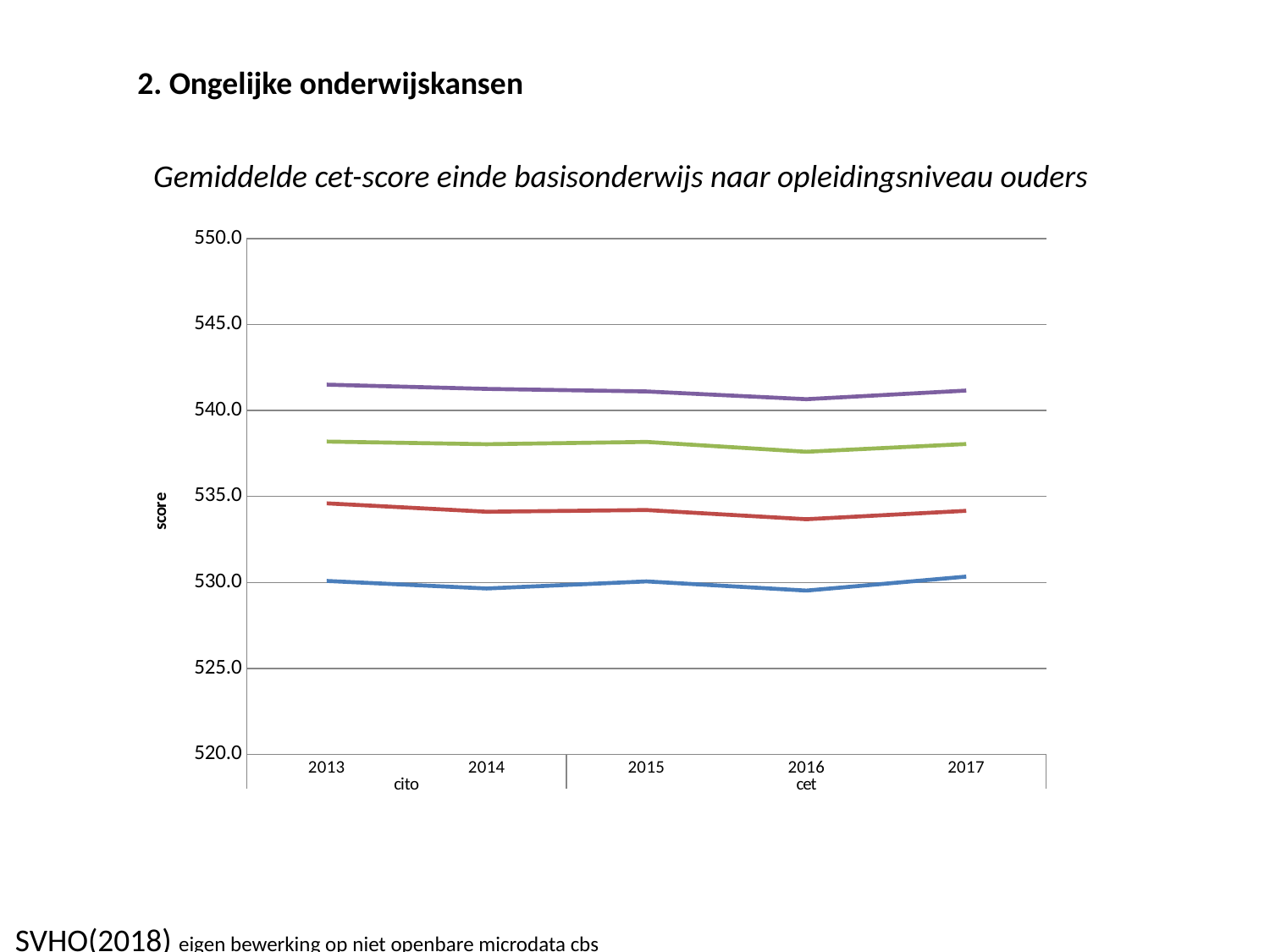
What is the title of the chart? Gemiddelde cet-score einde basisonderwijs naar opleidingsniveau ouders Is the value of the purple line in 2013 greater or less than 540.0? greater How many lines are plotted in the chart? 4 Is the value of the green line in 2015 greater or less than 540.0? less Is the value of the red line in 2014 greater or less than 535.0? less How many years are shown along the x axis of the chart? 5 Which line has the highest values across all years: the purple, green, red or blue line? purple In 2016, is the value of the red line larger or smaller than the value of the green line? smaller Which line has the lowest values across all years: the purple, green, red or blue line? blue What kind of chart is shown on the slide? line chart